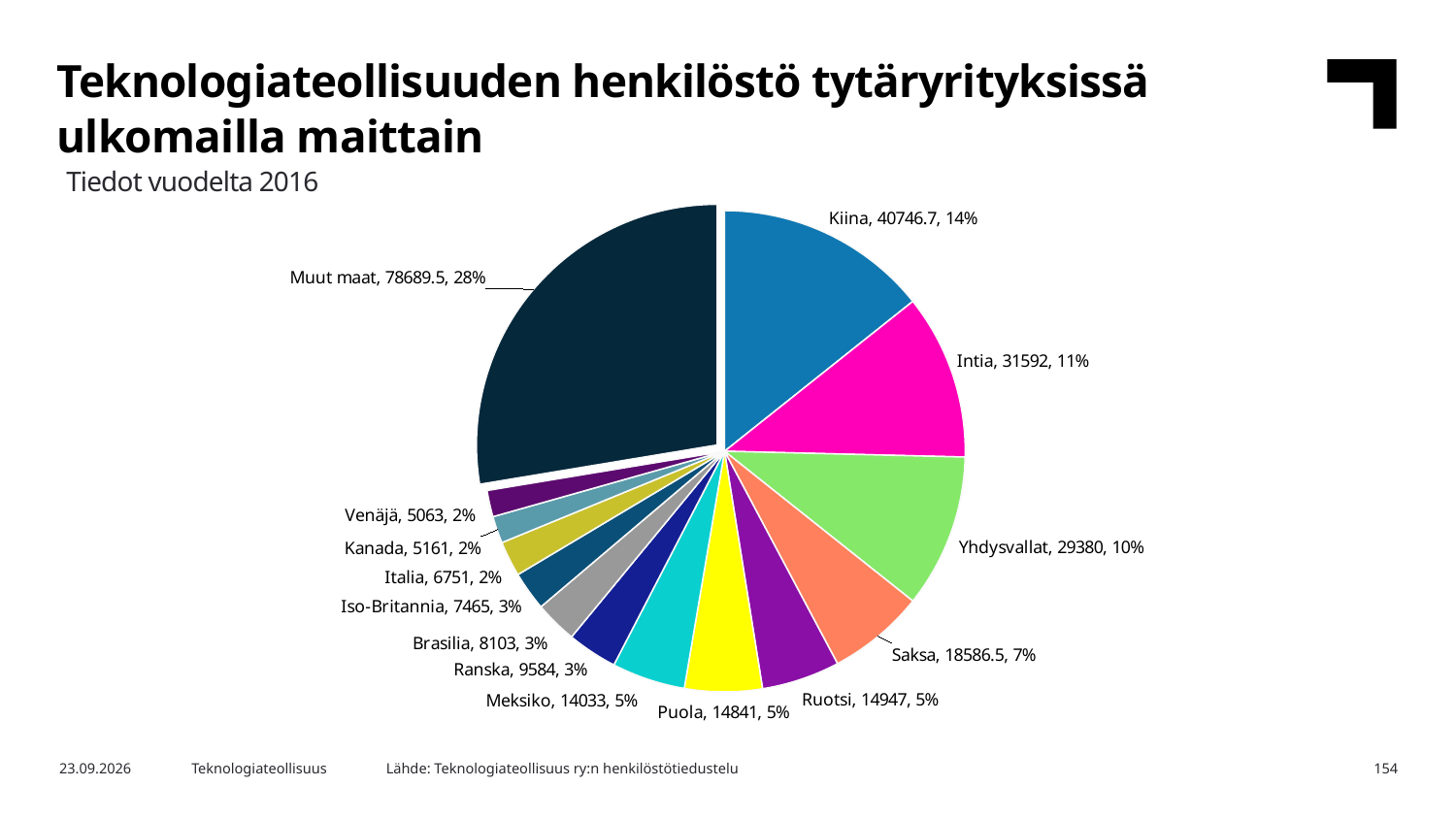
What share of the pie does Muut maat represent? 28% What share of the pie does Intia represent? 11% What is the value shown for Saksa? 18586.5 What is the difference between the values for Intia and Yhdysvallat? 2212 Which slice is the smallest in the pie chart? Venäjä What type of chart is shown on the slide? pie chart How many slices does the pie chart have? 14 What is the value shown for Meksiko? 14033 Which year do the data on the slide refer to? 2016 What is the value shown for Kiina? 40746.7 Which slice is the largest in the pie chart? Muut maat Which has a larger value, Ruotsi or Puola? Ruotsi